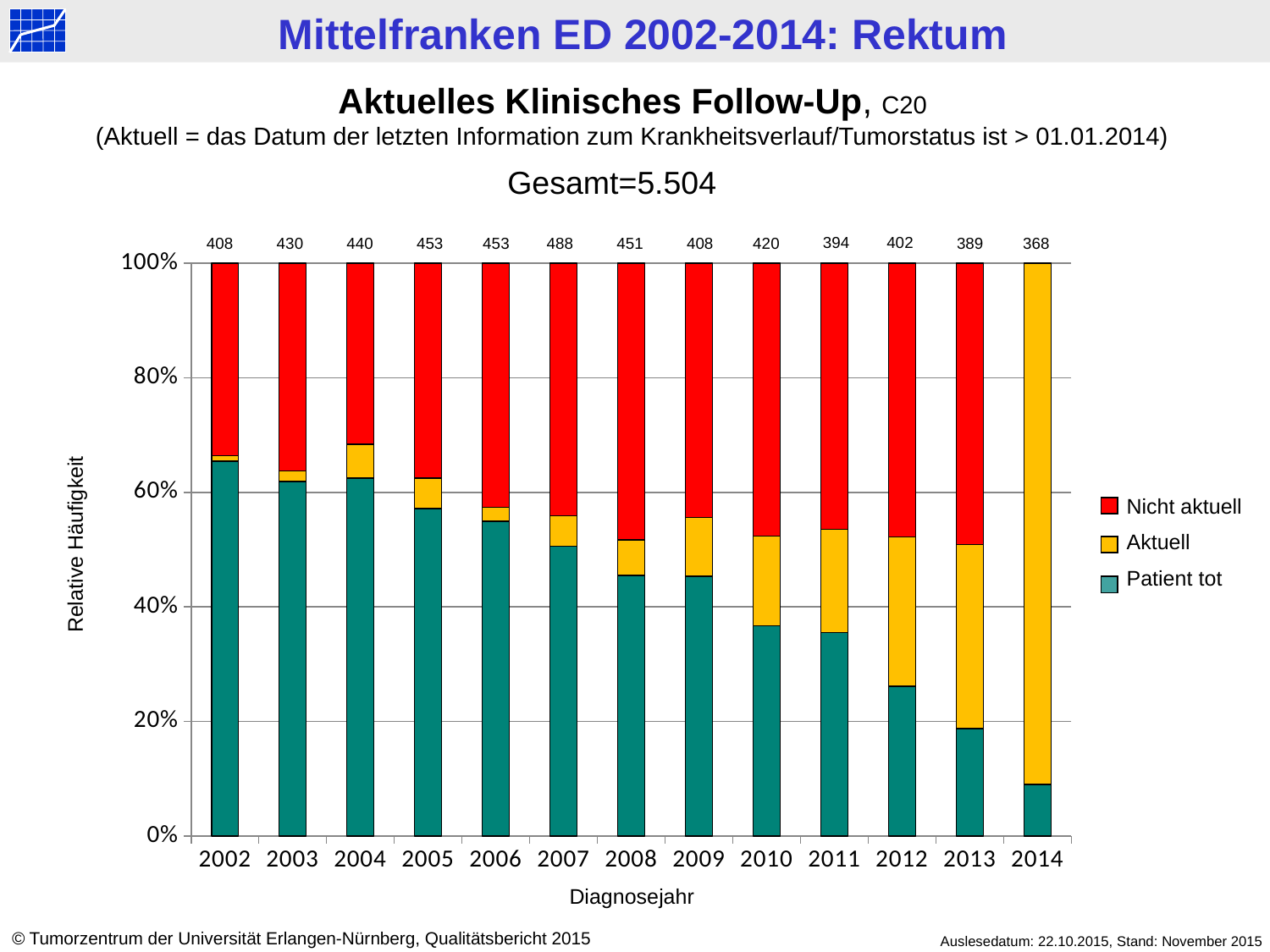
What kind of chart is shown on the slide? Stacked bar chart How many diagnosis years are shown on the x axis? 13 Which year has the larger number printed above its bar, 2002 or 2003? 2003 What is the difference between the numbers printed above the bars for 2007 and 2014? 120 What number is printed above the bar for 2002? 408 Which diagnosis year has the lowest number printed above its bar? 2014 How many series does the legend list? 3 Which diagnosis year has the highest number printed above its bar? 2007 What number is printed above the bar for 2007? 488 What number is printed above the bar for 2014? 368 Is the 'Patient tot' share for 2002 greater or less than 60%? greater Is the 'Patient tot' share for 2014 greater or less than 20%? less